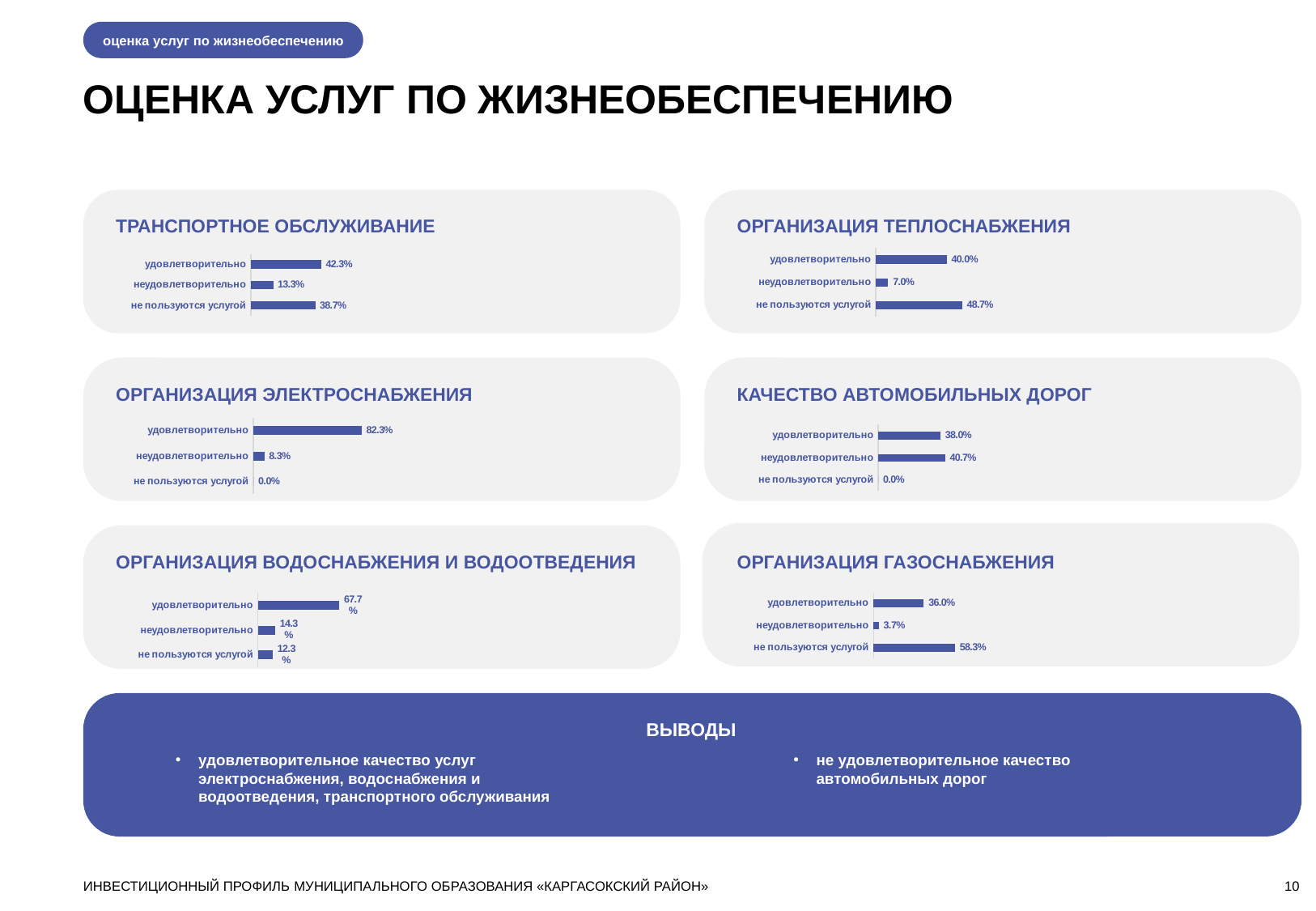
In the chart titled «ТРАНСПОРТНОЕ ОБСЛУЖИВАНИЕ», what is the value for «удовлетворительно»? 42.3% In the chart titled «ОРГАНИЗАЦИЯ ГАЗОСНАБЖЕНИЯ», which category has the lowest value? неудовлетворительно In the chart titled «ОРГАНИЗАЦИЯ ГАЗОСНАБЖЕНИЯ», what is the value for «не пользуются услугой»? 58.3% In the chart titled «ОРГАНИЗАЦИЯ ВОДОСНАБЖЕНИЯ И ВОДООТВЕДЕНИЯ», what is the difference between «удовлетворительно» and «неудовлетворительно»? 53.4% In the chart titled «ОРГАНИЗАЦИЯ ТЕПЛОСНАБЖЕНИЯ», which category has the highest value? не пользуются услугой In the chart titled «ОРГАНИЗАЦИЯ ТЕПЛОСНАБЖЕНИЯ», what is the value for «неудовлетворительно»? 7.0% What kind of chart is used in the «КАЧЕСТВО АВТОМОБИЛЬНЫХ ДОРОГ» panel? Bar chart In the chart titled «ОРГАНИЗАЦИЯ ЭЛЕКТРОСНАБЖЕНИЯ», what is the value for «удовлетворительно»? 82.3% How many categories are shown in the chart titled «ТРАНСПОРТНОЕ ОБСЛУЖИВАНИЕ»? 3 In the chart titled «ТРАНСПОРТНОЕ ОБСЛУЖИВАНИЕ», what is the difference between «удовлетворительно» and «не пользуются услугой»? 3.6% How many charts are shown on the slide? 6 In the chart titled «КАЧЕСТВО АВТОМОБИЛЬНЫХ ДОРОГ», which is larger: «удовлетворительно» or «неудовлетворительно»? неудовлетворительно